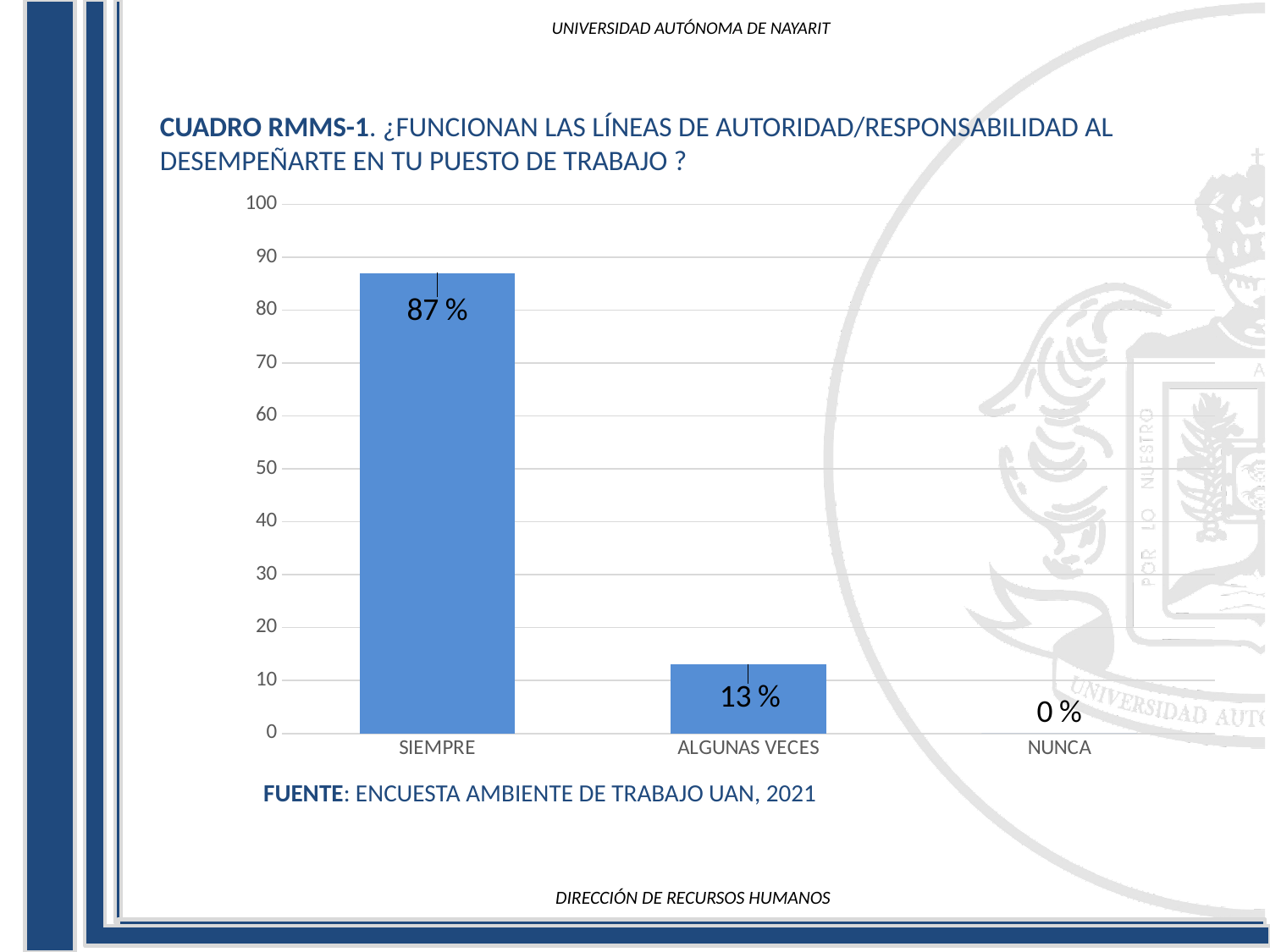
Which category has the highest value? SIEMPRE Which is larger, the value for ALGUNAS VECES or the value for NUNCA? ALGUNAS VECES How many categories are shown on the x axis? 3 What kind of chart is shown on the slide? bar chart What is the difference between the values for SIEMPRE and ALGUNAS VECES? 74 % What is the source cited below the chart? ENCUESTA AMBIENTE DE TRABAJO UAN, 2021 What is the value for NUNCA? 0 % What is the value for SIEMPRE? 87 % Is the value for ALGUNAS VECES greater or less than 20? less Which category has the lowest value? NUNCA What is the value for ALGUNAS VECES? 13 % Is the value for SIEMPRE greater or less than 80? greater